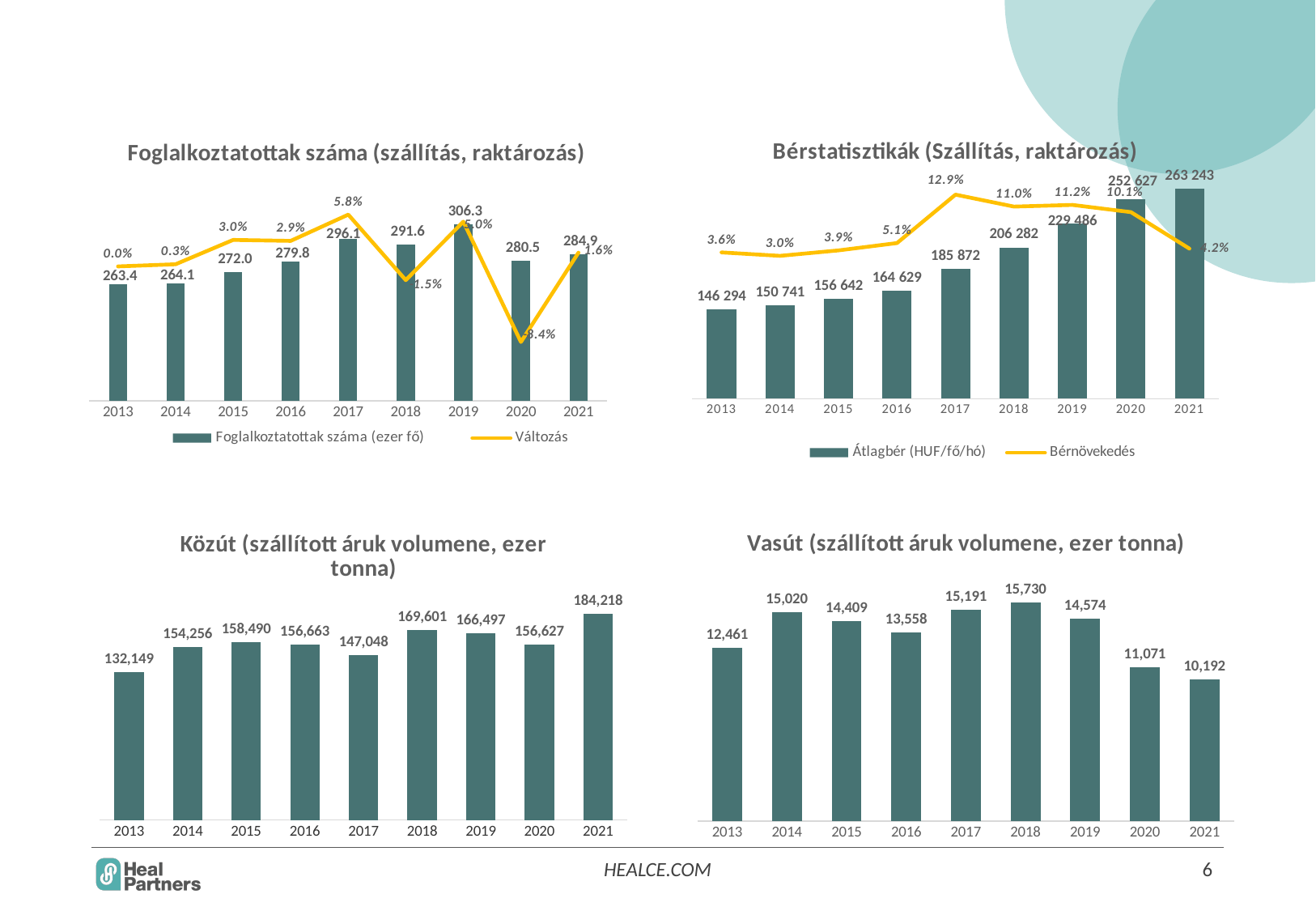
In the 'Vasút (szállított áruk volumene, ezer tonna)' chart, which is larger, the value for 2014 or the value for 2017? 2017 In the 'Bérstatisztikák (Szállítás, raktározás)' chart, what is the difference between the Átlagbér values for 2021 and 2020? 10 616 In the 'Közút (szállított áruk volumene, ezer tonna)' chart, which year has the lowest value? 2013 In the 'Foglalkoztatottak száma (szállítás, raktározás)' chart, how many series does the legend list? 2 In the 'Foglalkoztatottak száma (szállítás, raktározás)' chart, what is the Változás value for 2020? -8.4% In the 'Vasút (szállított áruk volumene, ezer tonna)' chart, which year has the highest value? 2018 What kind of chart is the 'Vasút (szállított áruk volumene, ezer tonna)' chart? Bar chart In the 'Közút (szállított áruk volumene, ezer tonna)' chart, what is the value for 2018? 169,601 In the 'Bérstatisztikák (Szállítás, raktározás)' chart, what is the Átlagbér value for 2017? 185 872 In the 'Foglalkoztatottak száma (szállítás, raktározás)' chart, what is the value of the bar for 2019? 306.3 In the 'Bérstatisztikák (Szállítás, raktározás)' chart, which year has the highest Bérnövekedés value? 2017 In the 'Közút (szállított áruk volumene, ezer tonna)' chart, how many years are shown on the x axis? 9